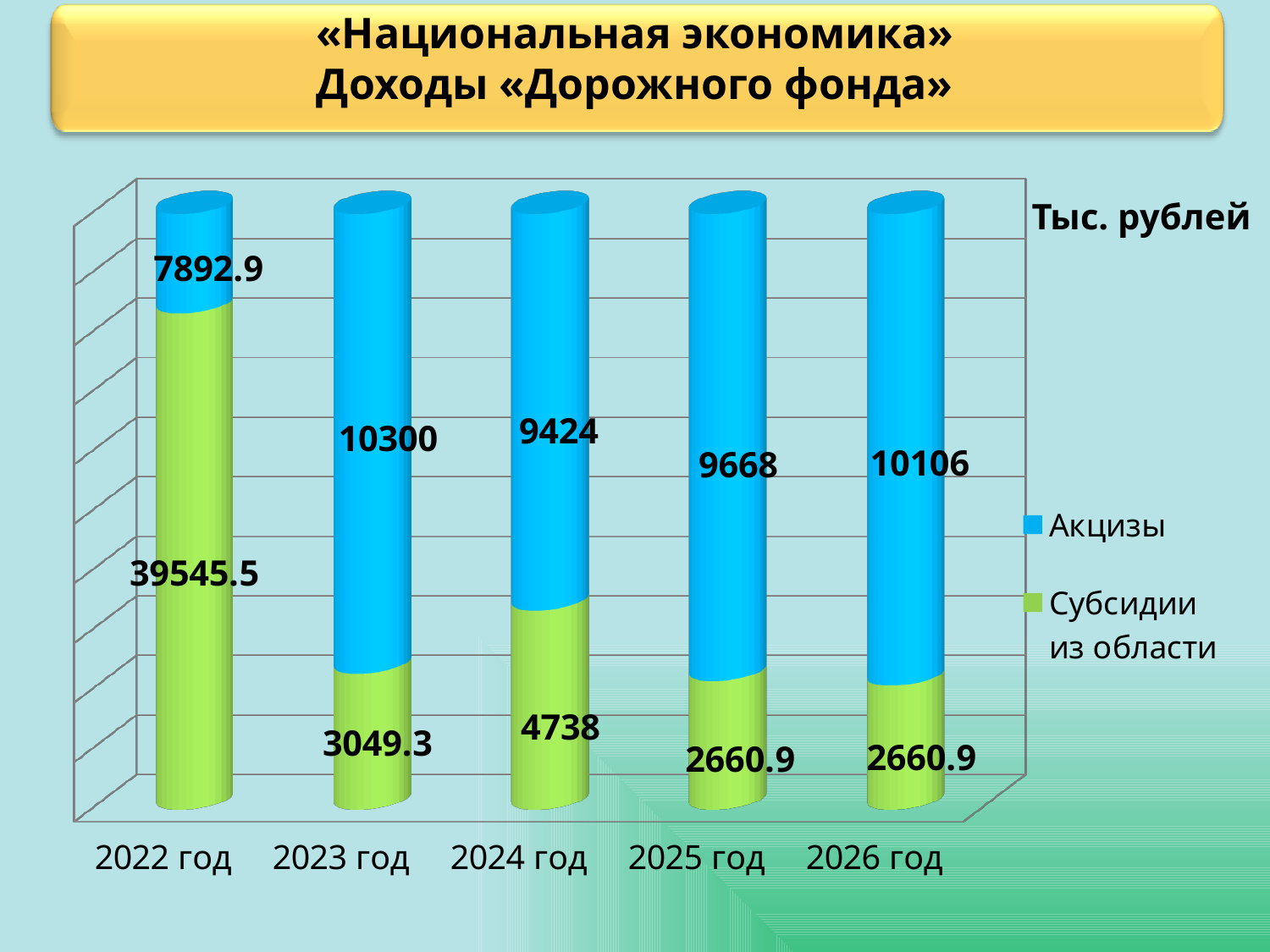
In which year is the Акцизы value the highest? 2023 год What is the value of Субсидии из области for 2022 год? 39545.5 What is the value of Субсидии из области for 2024 год? 4738 In which year is the Акцизы value the lowest? 2022 год What is the value of Акцизы for 2023 год? 10300 How many years are shown on the x axis? 5 Which is larger: Акцизы in 2023 год or Акцизы in 2026 год? 2023 год What is the value of Акцизы for 2026 год? 10106 In which year is the Субсидии из области value the highest? 2022 год What is the total of Акцизы and Субсидии из области for 2024 год? 14162 What is the difference between the Акцизы values for 2025 год and 2024 год? 244 How many series does the legend list? 2